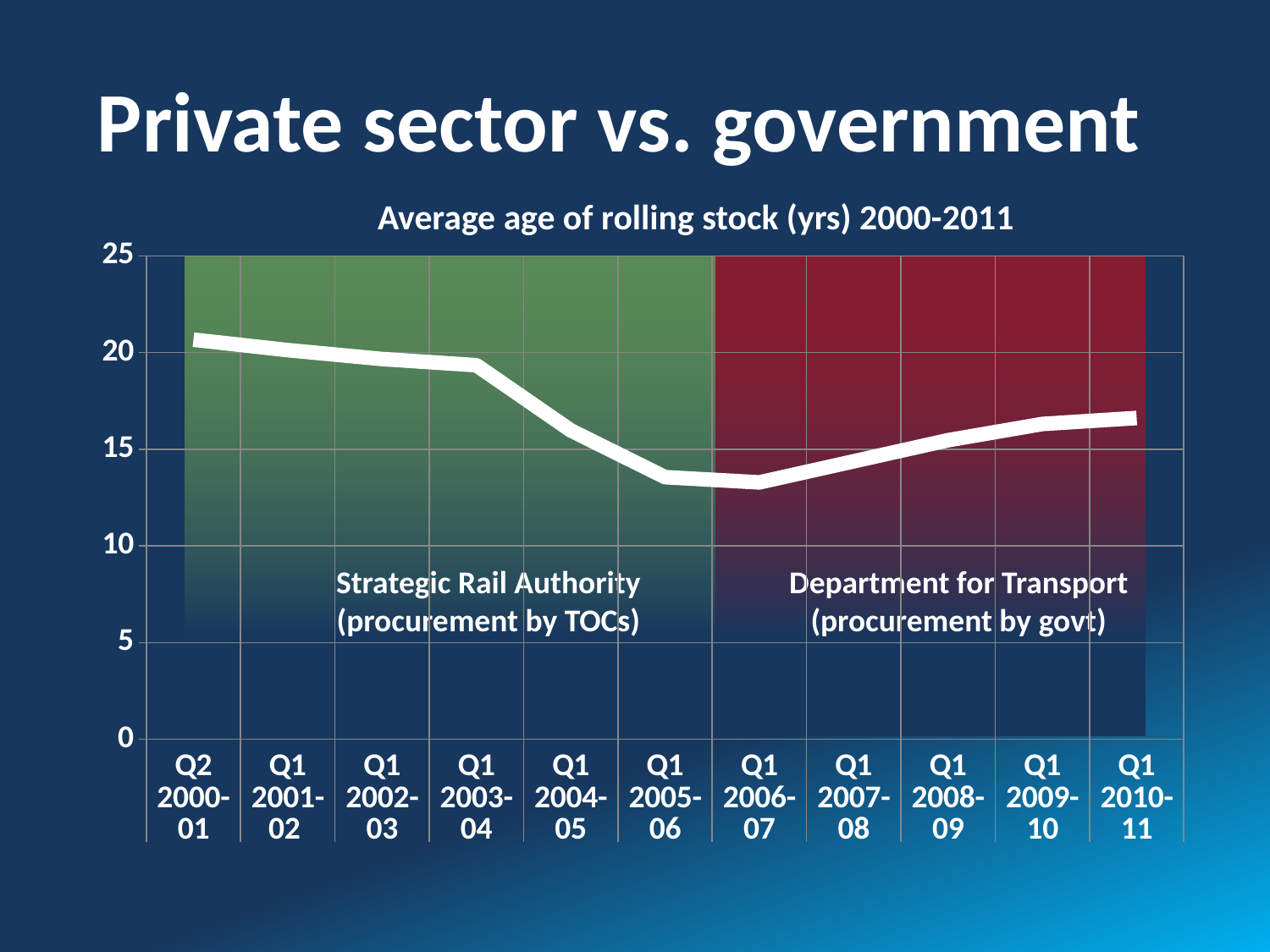
Does the average age of rolling stock rise or fall between Q1 2006-07 and Q1 2010-11? rise Which period has the highest average age of rolling stock? Q2 2000-01 What kind of chart is shown on the slide? line chart Which organisation is labelled on the red shaded region of the chart? Department for Transport (procurement by govt) Is the value for Q1 2005-06 greater or less than 15? less Which is larger, the value for Q1 2003-04 or the value for Q1 2004-05? Q1 2003-04 What is the title of the chart? Average age of rolling stock (yrs) 2000-2011 Is the value for Q1 2010-11 greater or less than 15? greater Does the average age of rolling stock rise or fall between Q2 2000-01 and Q1 2005-06? fall Is the value for Q1 2003-04 greater or less than 15? greater How many data points are plotted along the x axis? 11